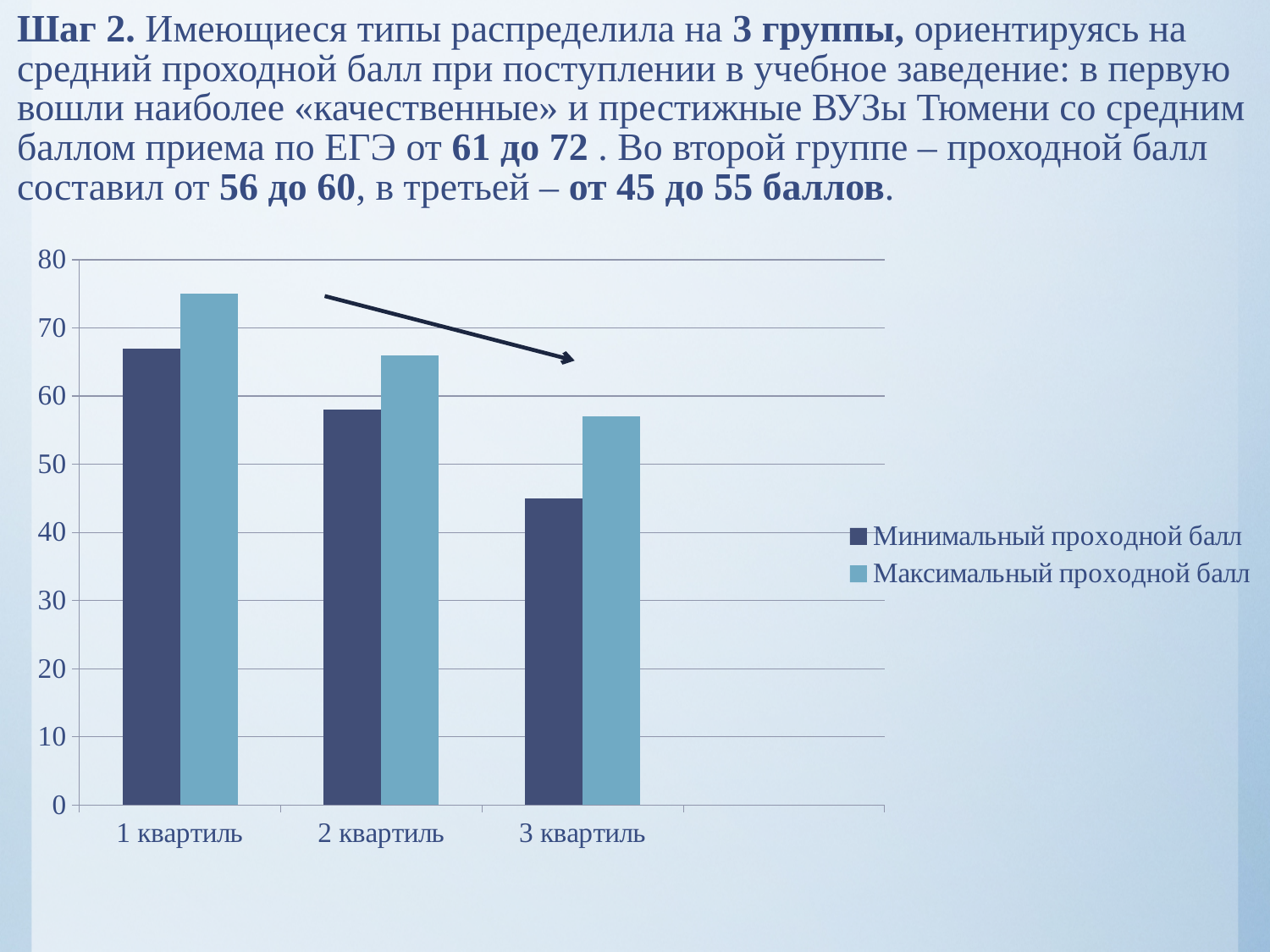
Which is larger: Минимальный проходной балл in 1 квартиль or Максимальный проходной балл in 3 квартиль? Минимальный проходной балл in 1 квартиль Is the value for Минимальный проходной балл in 3 квартиль greater or less than 50? less How many series does the chart's legend list? 2 Which category has the lowest value for Минимальный проходной балл? 3 квартиль How many categories are shown on the x axis of the chart? 3 Is the value for Максимальный проходной балл in 1 квартиль greater or less than 70? greater Do the values for Минимальный проходной балл rise or fall from 1 квартиль to 3 квартиль? fall Which series is shown in the darker blue bars according to the legend? Минимальный проходной балл Which category has the highest value for Максимальный проходной балл? 1 квартиль Is the value for Максимальный проходной балл in 2 квартиль greater or less than 60? greater What kind of chart is shown on the slide? bar chart